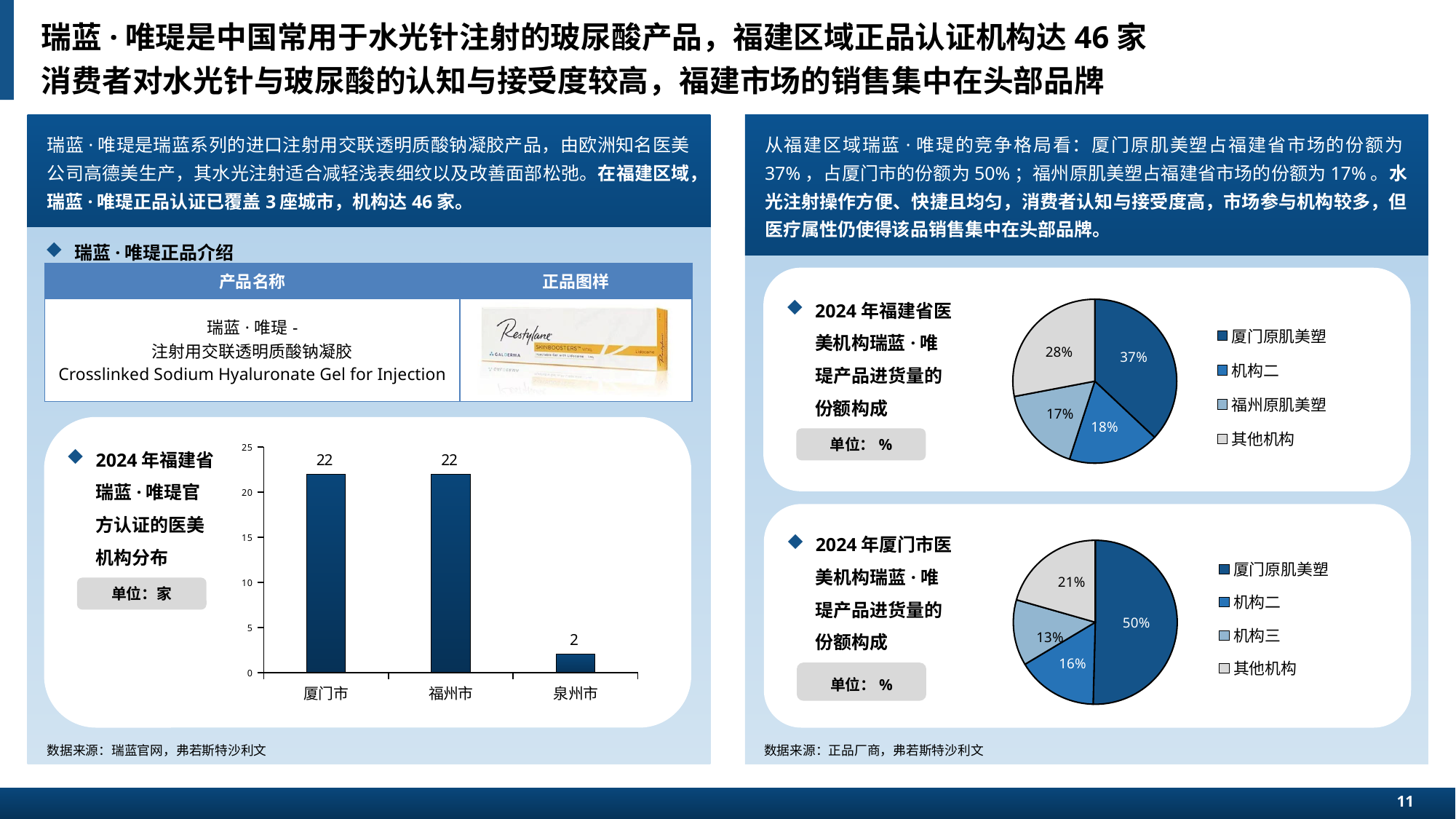
In the pie chart '2024 年福建省医美机构瑞蓝·唯瑅产品进货量的份额构成', what is the share for 福州原肌美塑? 17% In the bar chart '2024 年福建省瑞蓝·唯瑅官方认证的医美机构分布', what is the value for 厦门市? 22 In the bar chart '2024 年福建省瑞蓝·唯瑅官方认证的医美机构分布', what is the difference between the values for 福州市 and 泉州市? 20 In the bar chart '2024 年福建省瑞蓝·唯瑅官方认证的医美机构分布', which city has the lowest value? 泉州市 In the bar chart '2024 年福建省瑞蓝·唯瑅官方认证的医美机构分布', what is the value for 泉州市? 2 How many cities are shown in the bar chart '2024 年福建省瑞蓝·唯瑅官方认证的医美机构分布'? 3 In the pie chart '2024 年厦门市医美机构瑞蓝·唯瑅产品进货量的份额构成', what is the share for 机构三? 13% What type of chart is '2024 年福建省瑞蓝·唯瑅官方认证的医美机构分布'? bar chart In the pie chart '2024 年厦门市医美机构瑞蓝·唯瑅产品进货量的份额构成', which is larger, the share for 机构二 or the share for 其他机构? 其他机构 In the pie chart '2024 年福建省医美机构瑞蓝·唯瑅产品进货量的份额构成', which category has the largest share? 厦门原肌美塑 In the pie chart '2024 年福建省医美机构瑞蓝·唯瑅产品进货量的份额构成', what is the share for 厦门原肌美塑? 37% How many entries does the legend list in the pie chart '2024 年厦门市医美机构瑞蓝·唯瑅产品进货量的份额构成'? 4